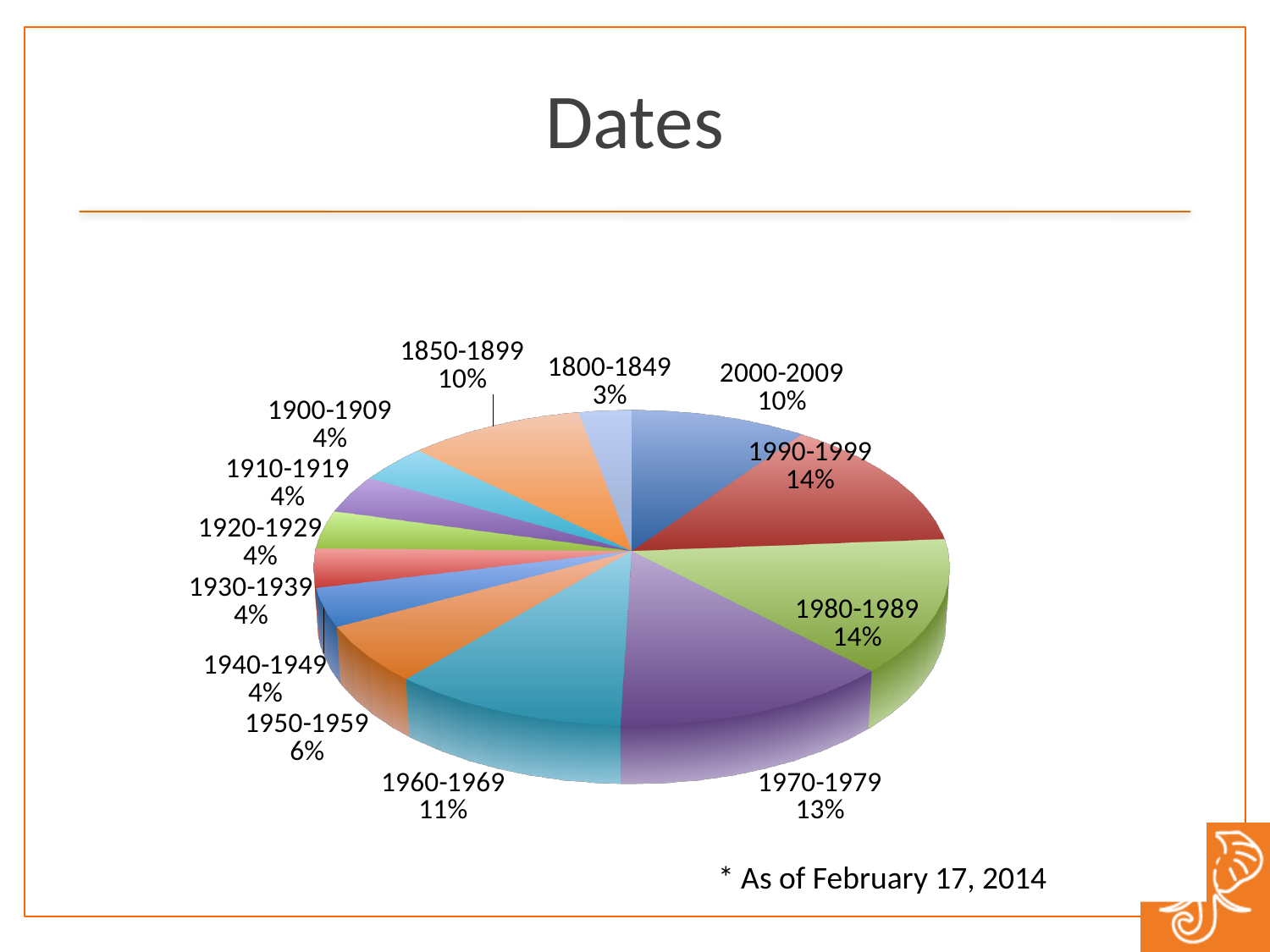
Which is larger, the share for 1960-1969 or the share for 1950-1959? 1960-1969 What is the title of the slide containing the pie chart? Dates What is the difference in percentage points between 1980-1989 and 2000-2009? 4 How many slices does the pie chart have? 13 What date is given in the footnote below the chart? February 17, 2014 What percentage is shown for 1850-1899? 10% What kind of chart is shown on the slide? pie chart What is the difference in percentage points between 1970-1979 and 1800-1849? 10 What share of the pie does the 1970-1979 slice represent? 13% What percentage is shown for 1950-1959? 6% Which date range has the smallest share of the pie? 1800-1849 What percentage is shown for 1960-1969? 11%